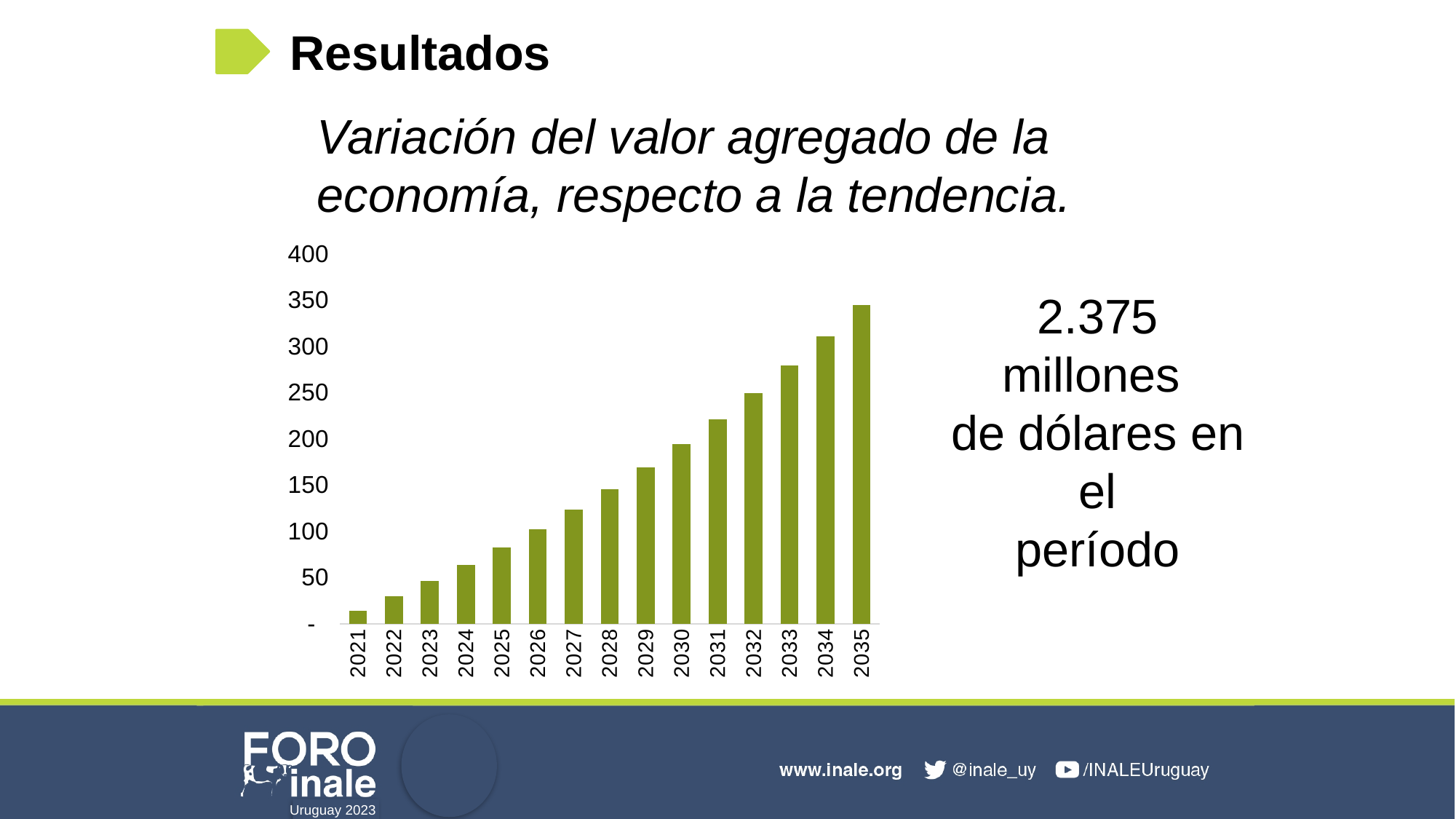
Is the value for 2021 greater or less than 50? less What kind of chart is shown on the slide? Bar chart Which is larger, the value for 2030 or the value for 2025? 2030 Which year has the highest bar on the chart? 2035 Is the value for 2029 greater or less than 150? greater Which year has the lowest bar on the chart? 2021 How many years (bars) are plotted on the chart? 15 Is the value for 2035 greater or less than 300? greater Do the values rise or fall from 2021 to 2035? Rise What is the title of the chart? Variación del valor agregado de la economía, respecto a la tendencia.